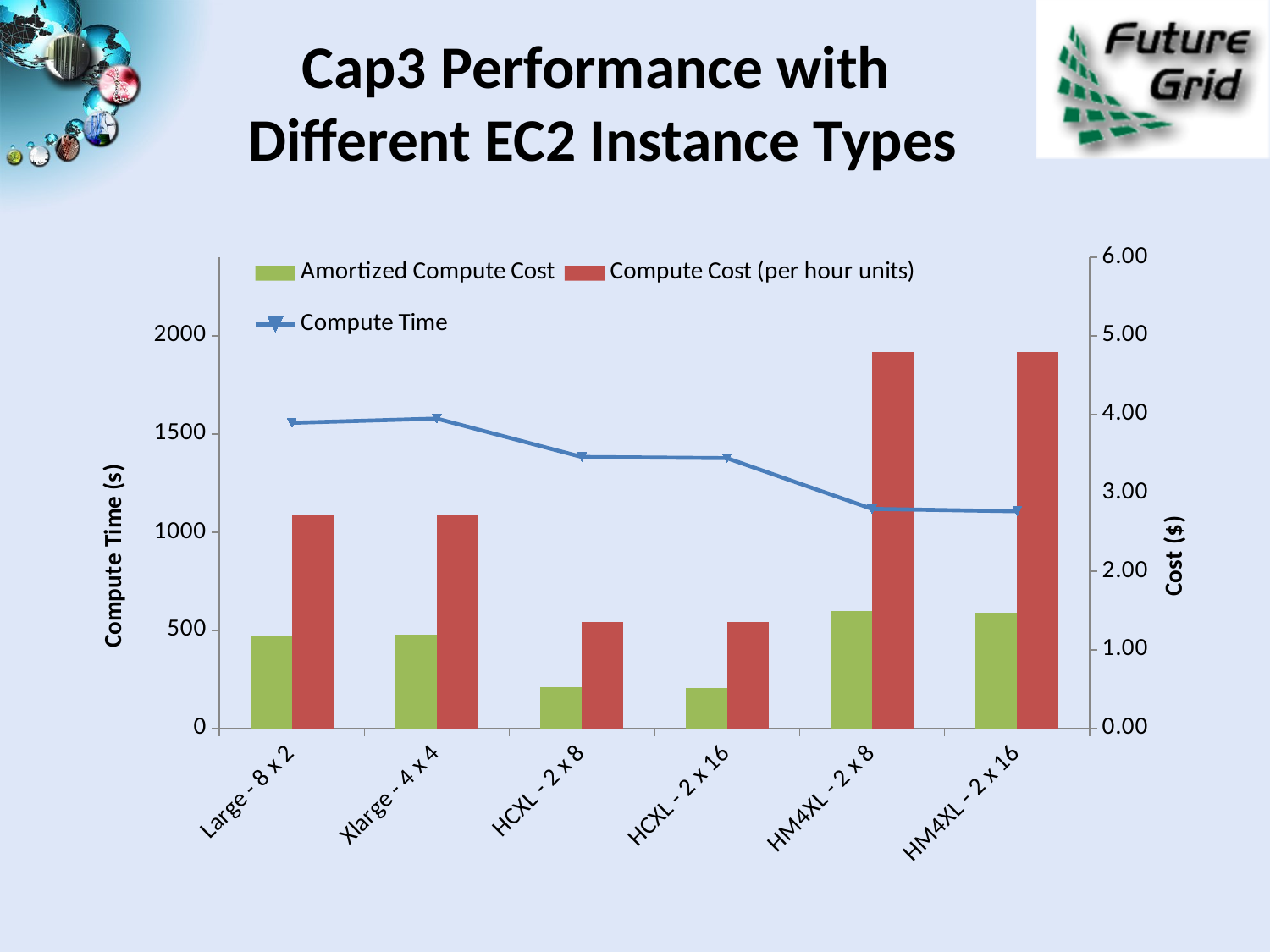
How many EC2 instance type categories are shown on the x axis of the chart? 6 Is the Compute Cost (per hour units) for HCXL - 2 x 8 greater or less than 2.00? less What kind of chart is used to show the Amortized Compute Cost and Compute Cost (per hour units) series? Bar chart Is the Compute Time for HCXL - 2 x 8 greater or less than 1000? greater Is the Amortized Compute Cost for HCXL - 2 x 16 greater or less than 1.00? less How many series does the chart legend list? 3 Which has the higher Compute Time: Large - 8 x 2 or HM4XL - 2 x 8? Large - 8 x 2 Which has the higher Compute Cost (per hour units): HM4XL - 2 x 8 or HCXL - 2 x 8? HM4XL - 2 x 8 What is the title of the right-hand vertical axis? Cost ($) Does the Compute Time line rise or fall from Large - 8 x 2 to HM4XL - 2 x 16? Fall